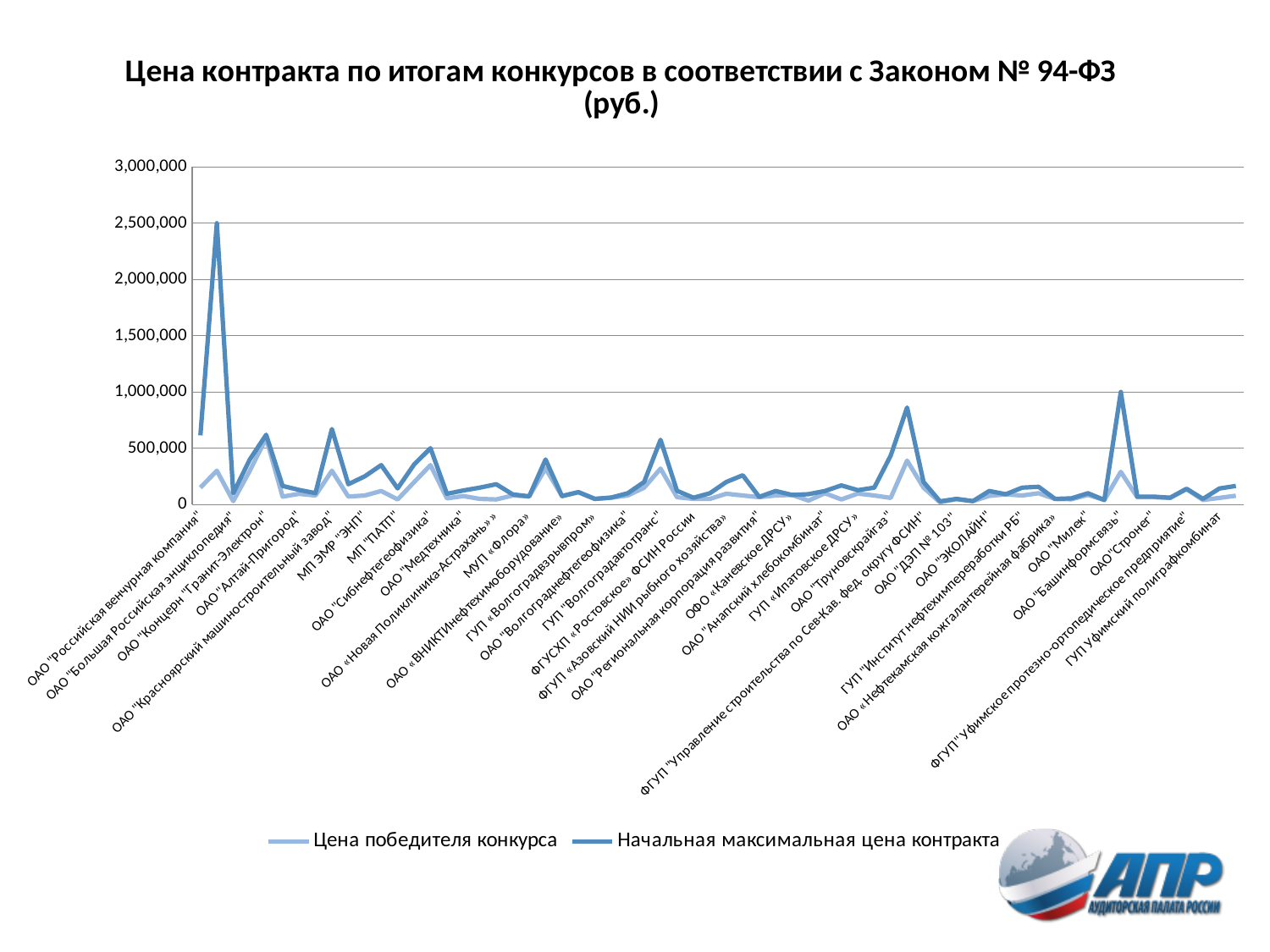
For ОАО "Башинформсвязь", which series has the larger value: 'Цена победителя конкурса' or 'Начальная максимальная цена контракта'? Начальная максимальная цена контракта Is the value of 'Цена победителя конкурса' for ОАО "Большая Российская энциклопедия" greater or less than 500,000? less Is the value of 'Начальная максимальная цена контракта' for ФГУП "Управление строительства по Сев-Кав. фед. округу ФСИН" greater or less than 500,000? less What is the highest value shown on the vertical axis? 3,000,000 Is the value of 'Начальная максимальная цена контракта' for ОАО "Большая Российская энциклопедия" greater or less than 2,000,000? less What is the title of the chart? Цена контракта по итогам конкурсов в соответствии с Законом № 94-ФЗ (руб.) For ОАО "Большая Российская энциклопедия", which series has the larger value: 'Цена победителя конкурса' or 'Начальная максимальная цена контракта'? Начальная максимальная цена контракта How many series does the legend list? 2 What are the two series named in the legend? Цена победителя конкурса; Начальная максимальная цена контракта What kind of chart is shown on the slide? line chart